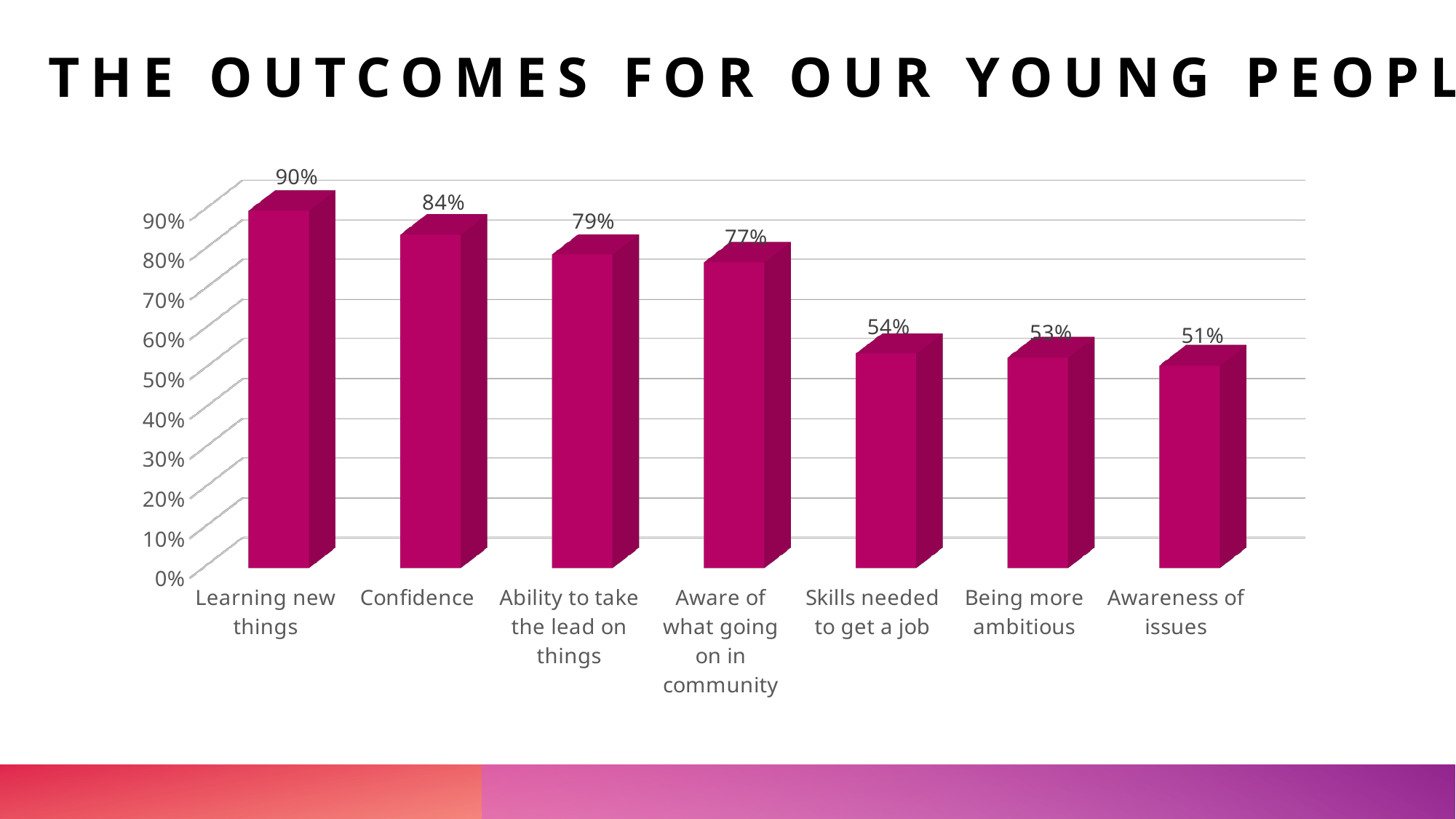
Which category has the highest value? Learning new things What is the difference between the values for Learning new things and Confidence? 6% Which category has the lowest value? Awareness of issues What kind of chart is shown on the slide? bar chart What is the value for Aware of what going on in community? 77% What is the value for Skills needed to get a job? 54% Do the values rise or fall from left to right along the x axis? fall What is the difference between the values for Ability to take the lead on things and Awareness of issues? 28% Which is larger, the value for Confidence or the value for Being more ambitious? Confidence What is the value for Confidence? 84% How many categories are shown on the chart? 7 Is the value for Ability to take the lead on things greater or less than 70%? greater